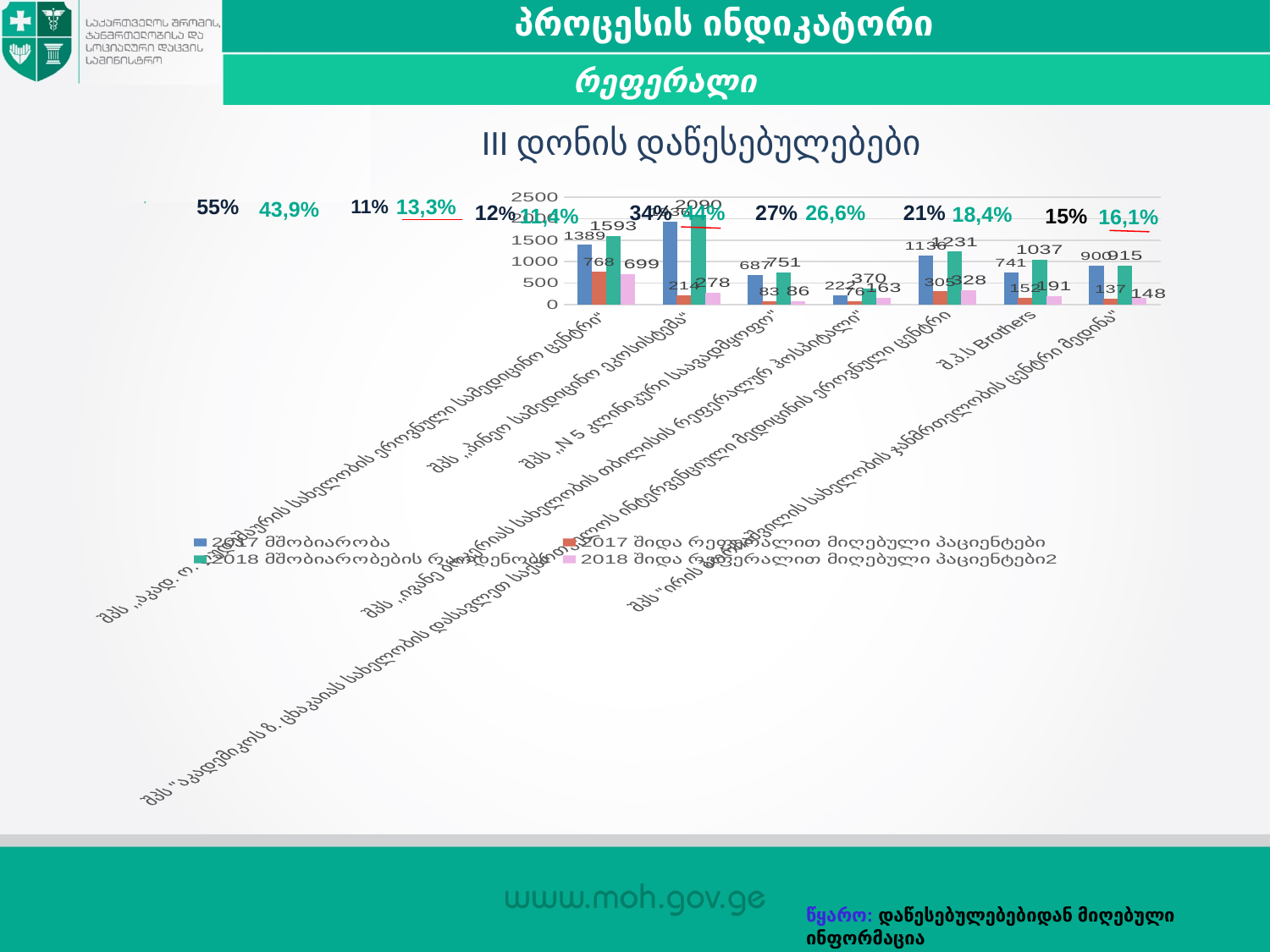
What is the value of 2017 შიდა რეფერალით მიღებული პაციენტები for შ.პ.ს Brothers? 152 Which has the larger 2017 მშობიარობა value: შ.პ.ს Brothers or შპს „N 5 კლინიკური საავადმყოფო"? შ.პ.ს Brothers What is the value of 2018 მშობიარობების რაოდენობა for შ.პ.ს Brothers? 1037 How many institutions (categories) are shown on the x axis of the chart? 7 Which institution has the highest value for 2018 მშობიარობების რაოდენობა? შპს „პინეო სამედიცინო ეკოსისტემა" What is the value of 2017 მშობიარობა for შპს „N 5 კლინიკური საავადმყოფო"? 687 How many series does the chart legend list? 4 Is the 2017 მშობიარობა value for შპს „პინეო სამედიცინო ეკოსისტემა" greater or less than 1500? greater What is the value of 2017 მშობიარობა for შ.პ.ს Brothers? 741 What is the value of 2018 მშობიარობების რაოდენობა for შპს „N 5 კლინიკური საავადმყოფო"? 751 What kind of chart is shown on the slide? bar chart What is the difference between the 2018 მშობიარობების რაოდენობა and 2017 მშობიარობა values for შ.პ.ს Brothers? 296